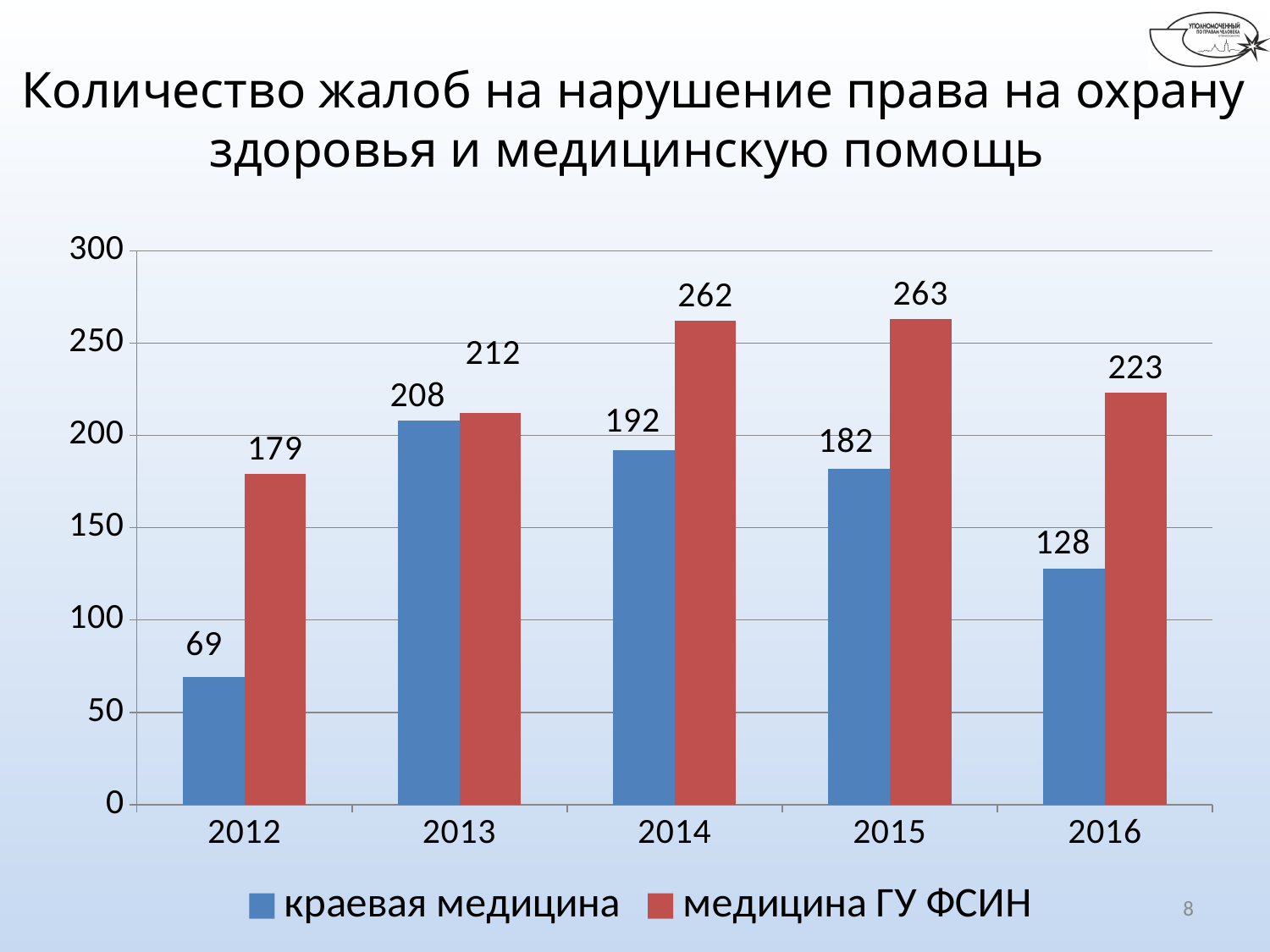
How many years are shown on the x axis? 5 How many series does the legend list? 2 In which year is the value for краевая медицина lowest? 2012 Which is larger in 2013: краевая медицина or медицина ГУ ФСИН? медицина ГУ ФСИН Which colour represents медицина ГУ ФСИН in the chart? red Is the value for краевая медицина in 2015 greater or less than 200? less What kind of chart is shown on the slide? bar chart In which year is the value for медицина ГУ ФСИН highest? 2015 What is the value for медицина ГУ ФСИН in 2016? 223 What is the difference between медицина ГУ ФСИН and краевая медицина in 2016? 95 What is the value for краевая медицина in 2014? 192 What is the value for краевая медицина in 2012? 69